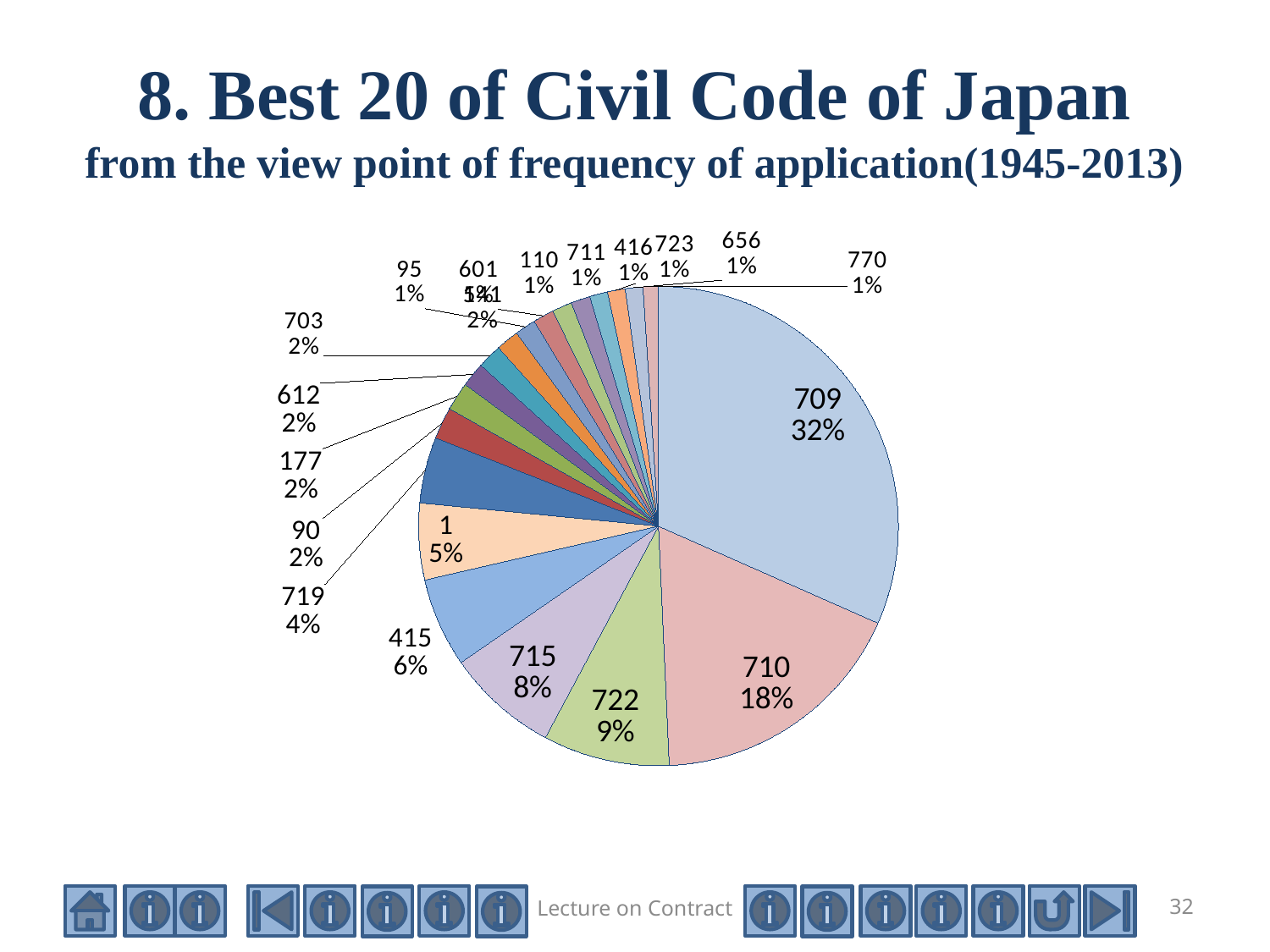
What percentage is shown for article 715? 8% What percentage is shown for article 722? 9% What percentage share does article 709 have? 32% What is the difference in percentage points between the shares of article 709 and article 710? 14 percentage points What percentage is shown for article 710? 18% What percentage is shown for article 415? 6% What period does the chart title say the frequency of application covers? 1945-2013 Which has the larger share, article 415 or article 1? 415 Which has the larger share, article 709 or article 710? 709 What kind of chart is shown on the slide? pie chart What percentage is shown for article 719? 4% Which article has the largest share of the pie? 709